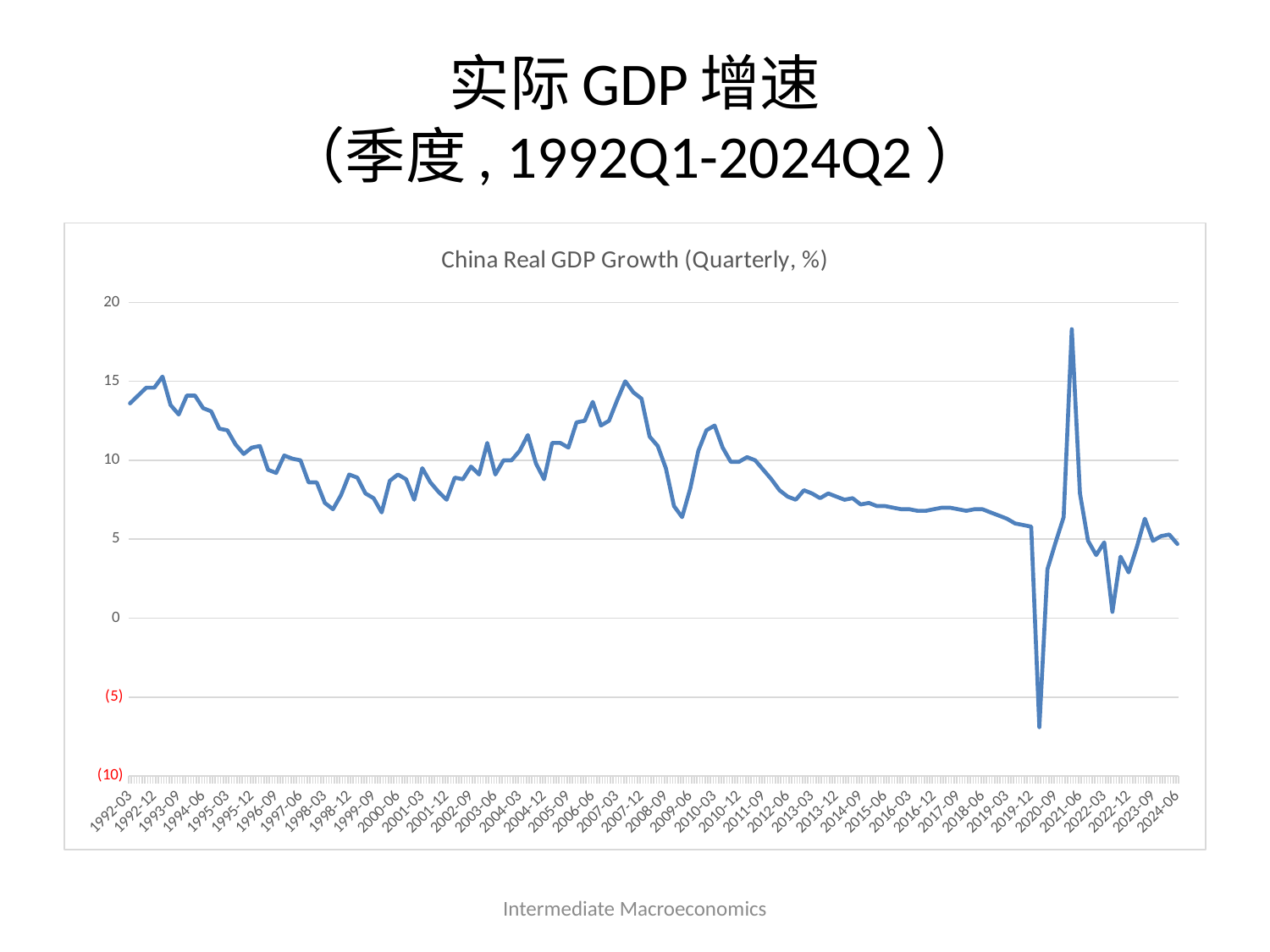
Is the value for 2022-12 greater or less than 5? less Is the value for 2007-03 greater or less than 10? greater In which year does the line reach its highest value? 2021 Is the value for 1992-03 greater or less than 10? greater Which is larger, the value for 2007-03 or the value for 2009-06? 2007-03 What kind of chart is shown on the slide? line chart What is the title printed inside the chart area? China Real GDP Growth (Quarterly, %) What is the lowest tick label shown on the vertical axis? (10) In which year does the line reach its lowest value? 2020 Does the line generally rise or fall between 2010-03 and 2019-03? fall